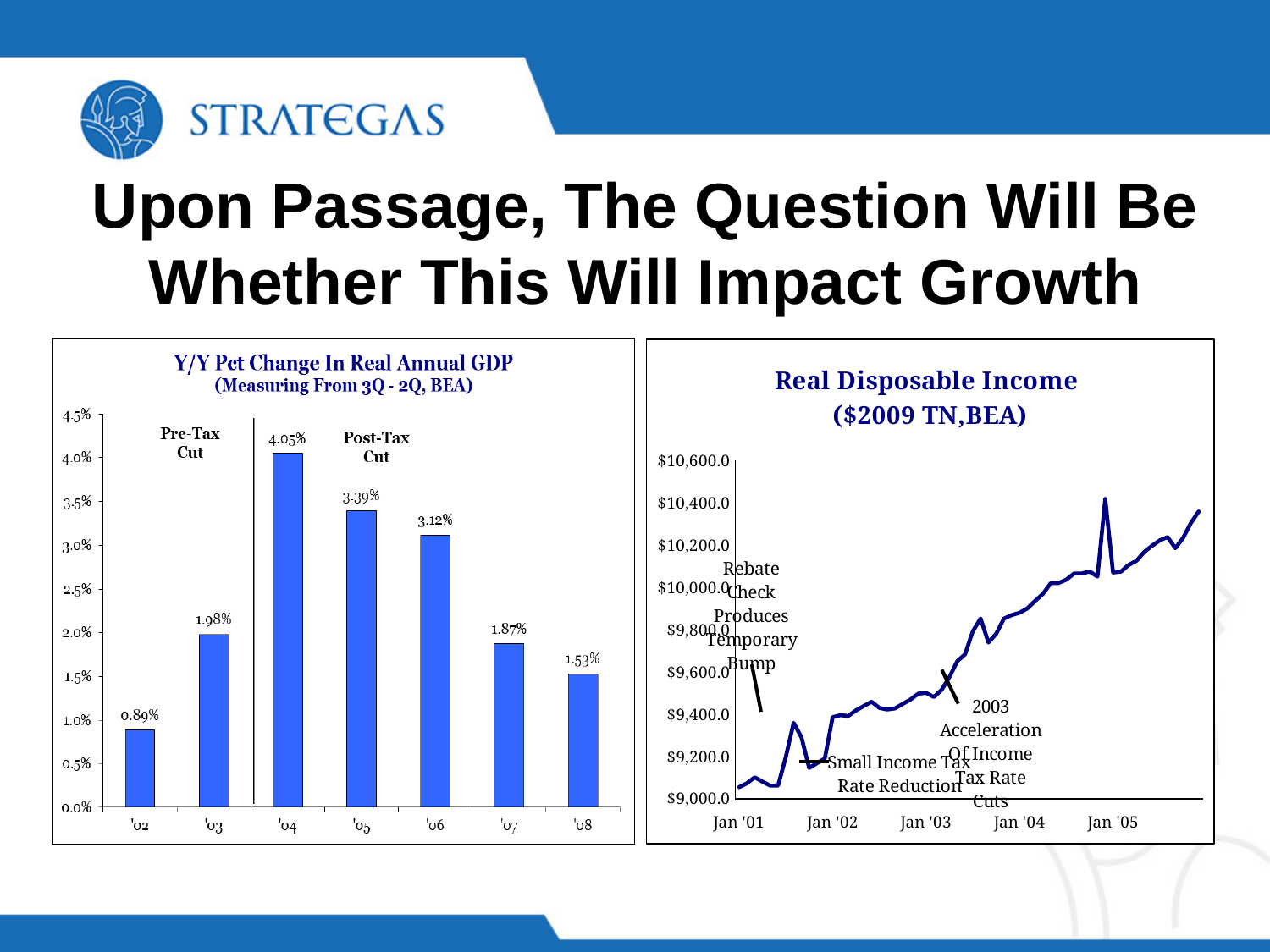
In the 'Y/Y Pct Change In Real Annual GDP' chart, what is the difference between the values for '04 and '05? 0.66 percentage points In the 'Y/Y Pct Change In Real Annual GDP' chart, what is the value for '02? 0.89% In the 'Y/Y Pct Change In Real Annual GDP' chart, which is larger, the value for '06 or the value for '07? '06 In the 'Y/Y Pct Change In Real Annual GDP' chart, which year has the highest value? '04 What kind of chart is the 'Real Disposable Income' chart? Line chart How many years are shown in the 'Y/Y Pct Change In Real Annual GDP' chart? 7 In the 'Y/Y Pct Change In Real Annual GDP' chart, which year has the lowest value? '02 In the 'Real Disposable Income' chart, do values generally rise or fall from Jan '01 to Jan '05? Rise In the 'Real Disposable Income' chart, is the value at Jan '01 greater or less than $9,200.0? less In the 'Y/Y Pct Change In Real Annual GDP' chart, what is the value for '04? 4.05% What kind of chart is the 'Y/Y Pct Change In Real Annual GDP' chart? Bar chart In the 'Y/Y Pct Change In Real Annual GDP' chart, what is the value for '08? 1.53%